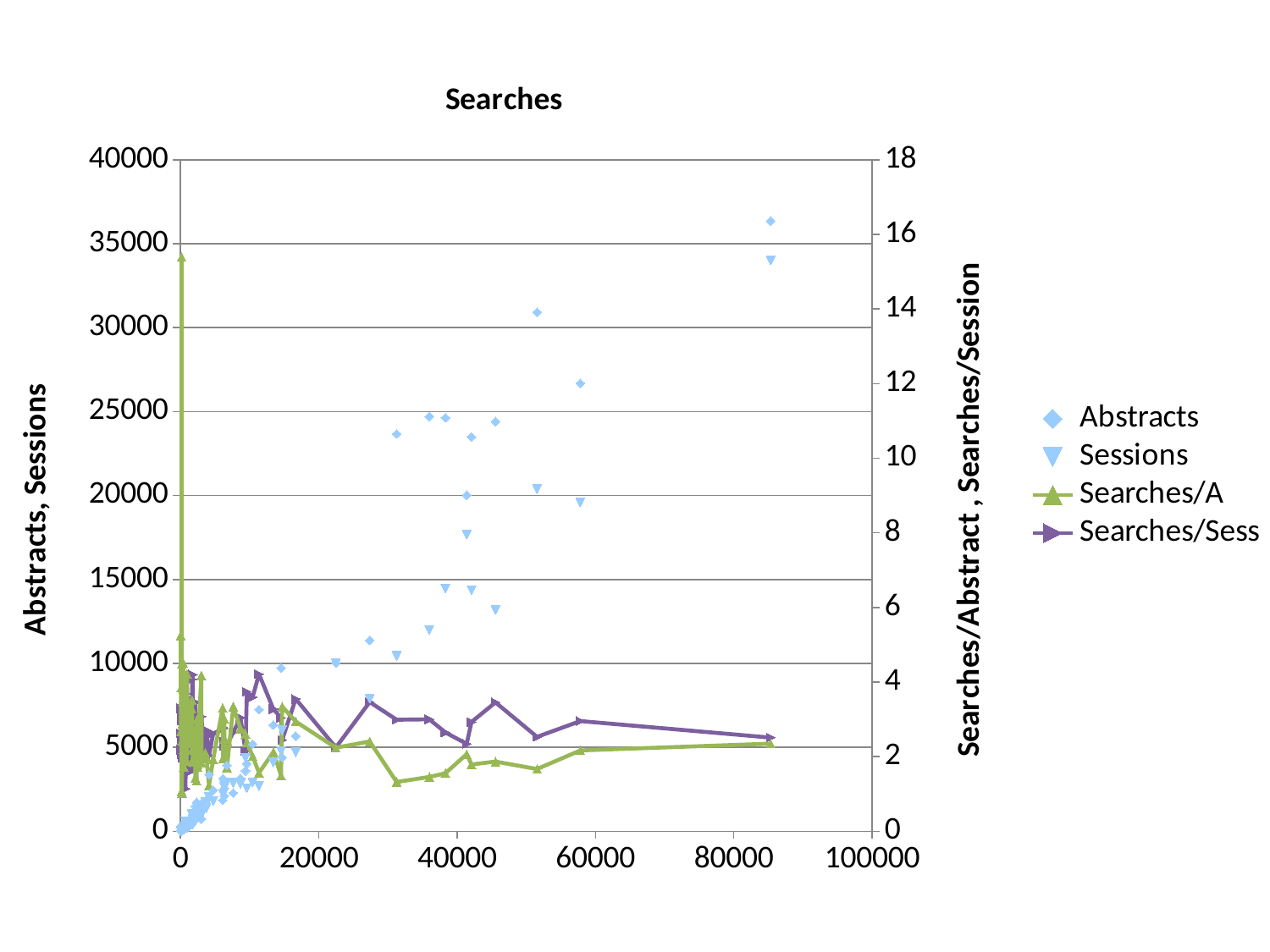
How many series does the legend list? 4 Is the highest Sessions point greater or less than 35000? less What is the maximum value shown on the right vertical axis? 18 What is the title of the left vertical axis? Abstracts, Sessions Is the Searches/Sess value at the far right of the chart (around 85000 on the x axis) greater or less than 4 on the right axis? less Is the highest Abstracts point greater or less than 35000? greater Which series reaches the highest value on the left axis? Abstracts What kind of chart is shown on the slide? scatter chart At the rightmost data points (around 85000 on the x axis), which is larger: Abstracts or Sessions? Abstracts Do the Abstracts values generally rise or fall as the x-axis value increases? rise What is the title of the chart? Searches